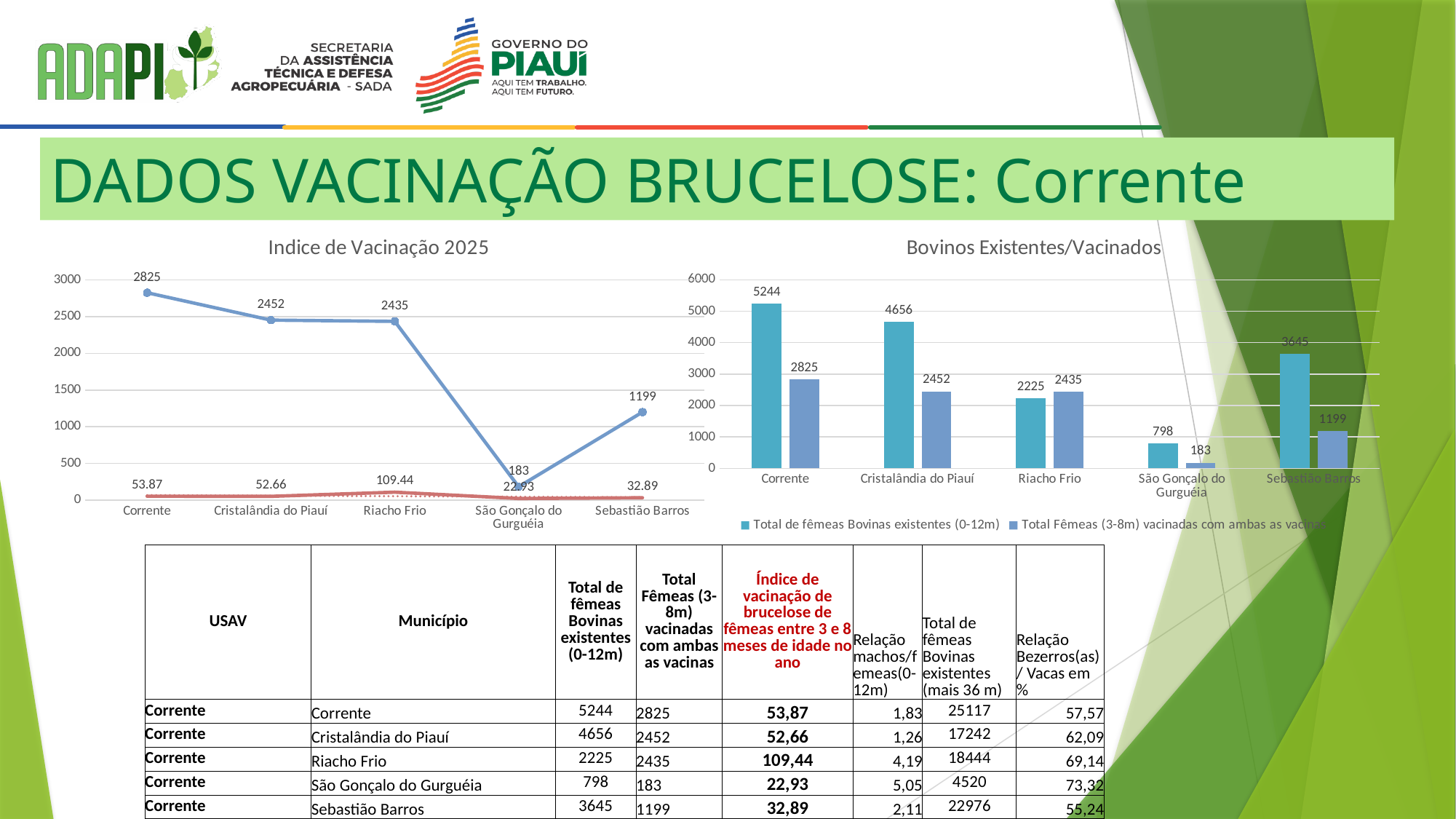
In the 'Bovinos Existentes/Vacinados' chart, which municipality has the lowest value for 'Total Fêmeas (3-8m) vacinadas com ambas as vacinas'? São Gonçalo do Gurguéia In the 'Bovinos Existentes/Vacinados' chart, what is the difference between the two bars for Cristalândia do Piauí? 2204 In the 'Indice de Vacinação 2025' chart, what is the value of the red line for Riacho Frio? 109.44 What type of chart is 'Indice de Vacinação 2025'? Line chart What type of chart is 'Bovinos Existentes/Vacinados'? Bar chart How many series does the legend of the 'Bovinos Existentes/Vacinados' chart list? 2 In the 'Bovinos Existentes/Vacinados' chart, what is the value of 'Total Fêmeas (3-8m) vacinadas com ambas as vacinas' for São Gonçalo do Gurguéia? 183 In the 'Bovinos Existentes/Vacinados' chart, which municipality has the highest value for 'Total de fêmeas Bovinas existentes (0-12m)'? Corrente In the 'Bovinos Existentes/Vacinados' chart, for Riacho Frio, which is larger: the existing females bar or the vaccinated females bar? Vaccinated females (2435) How many municipalities are shown on the x axis of the 'Indice de Vacinação 2025' chart? 5 In the 'Bovinos Existentes/Vacinados' chart, what is the value of 'Total de fêmeas Bovinas existentes (0-12m)' for Corrente? 5244 In the 'Indice de Vacinação 2025' chart, what is the value of the blue line for Sebastião Barros? 1199